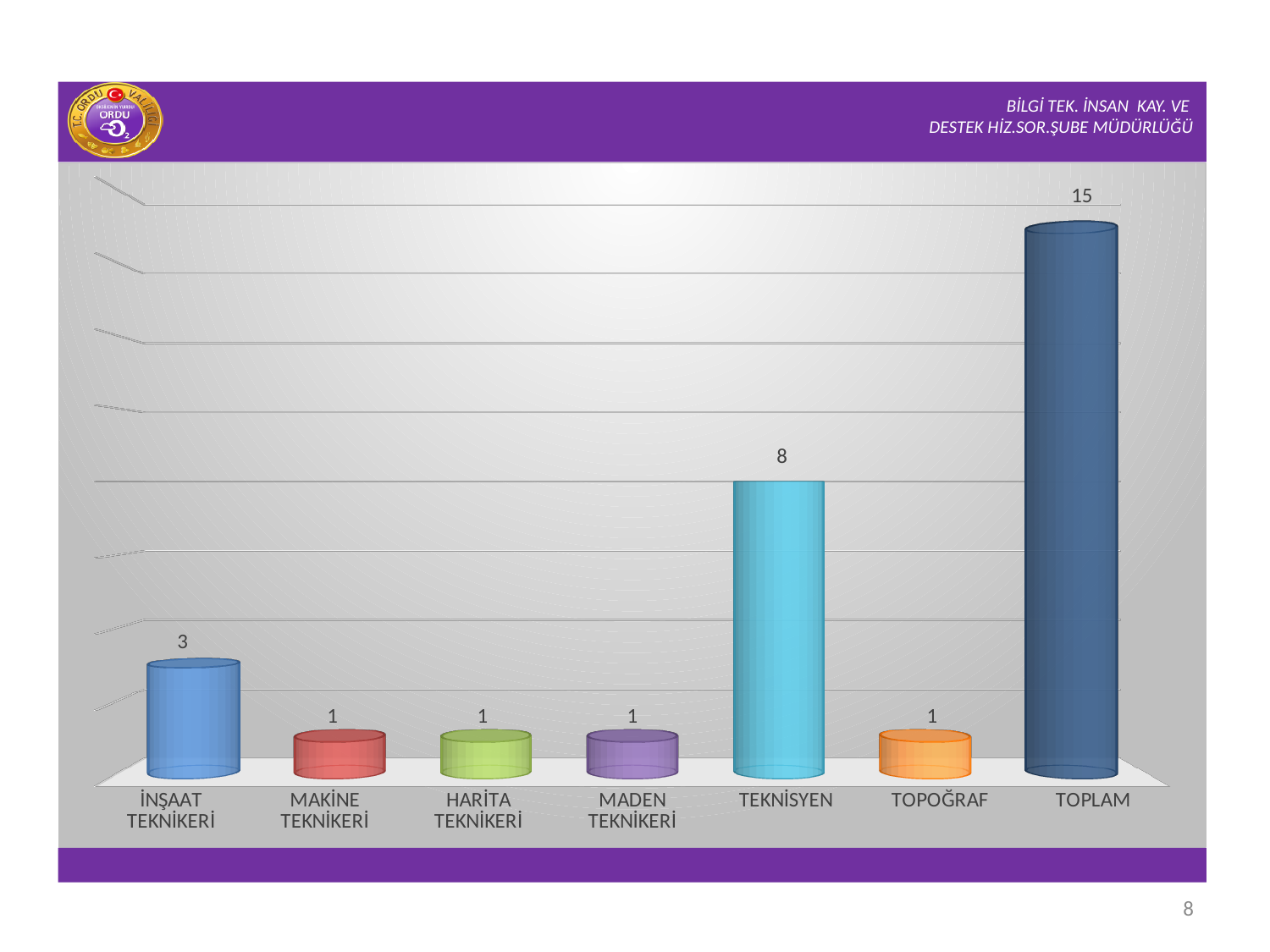
What is the value for TOPLAM? 15 What is the value for MADEN TEKNİKERİ? 1 What is the value for İNŞAAT TEKNİKERİ? 3 What is the difference between the values for TOPLAM and TEKNİSYEN? 7 Excluding TOPLAM, which category has the highest value? TEKNİSYEN How many categories are shown on the x axis? 7 What is the value for TOPOĞRAF? 1 Which is larger, the value for İNŞAAT TEKNİKERİ or the value for MAKİNE TEKNİKERİ? İNŞAAT TEKNİKERİ What is the value for TEKNİSYEN? 8 Which category has the highest value? TOPLAM What kind of chart is shown on the slide? Bar chart What is the difference between the values for TEKNİSYEN and İNŞAAT TEKNİKERİ? 5